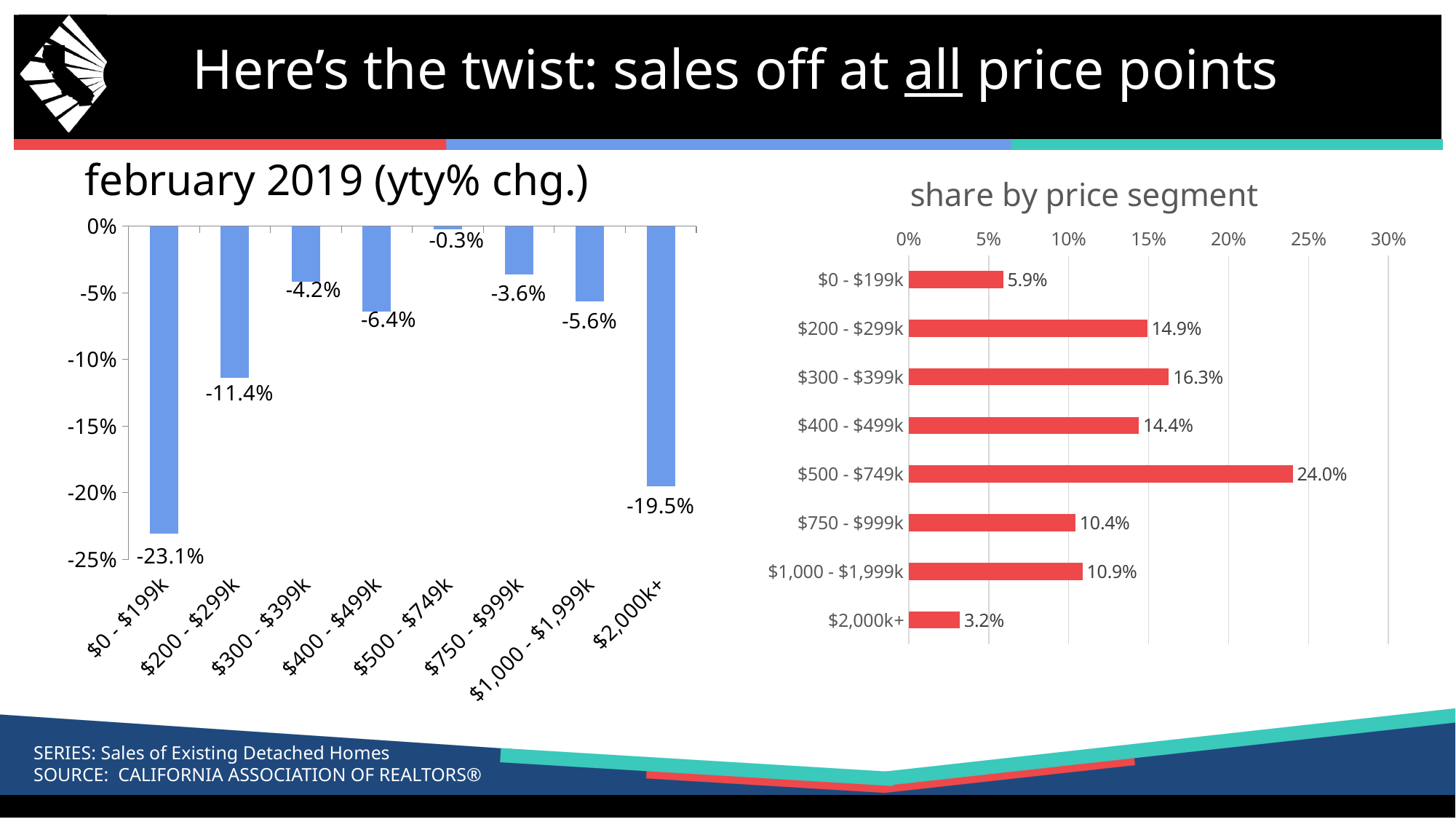
In the 'february 2019 (yty% chg.)' chart, what is the value for $0 - $199k? -23.1% In the 'share by price segment' chart, which price segment has the smallest share? $2,000k+ In the 'february 2019 (yty% chg.)' chart, what is the value for $500 - $749k? -0.3% In the 'february 2019 (yty% chg.)' chart, which price segment has the smallest decline? $500 - $749k What type of chart is the 'share by price segment' chart? Bar chart In the 'share by price segment' chart, which price segment has the largest share? $500 - $749k In the 'february 2019 (yty% chg.)' chart, which price segment has the largest decline? $0 - $199k In the 'february 2019 (yty% chg.)' chart, how many price segments are shown? 8 In the 'share by price segment' chart, what is the share for $500 - $749k? 24.0% In the 'share by price segment' chart, what is the difference between the shares for $1,000 - $1,999k and $750 - $999k? 0.5 percentage points In the 'share by price segment' chart, which is larger: the share for $300 - $399k or $400 - $499k? $300 - $399k In the 'february 2019 (yty% chg.)' chart, what is the difference between the values for $200 - $299k and $300 - $399k? 7.2 percentage points